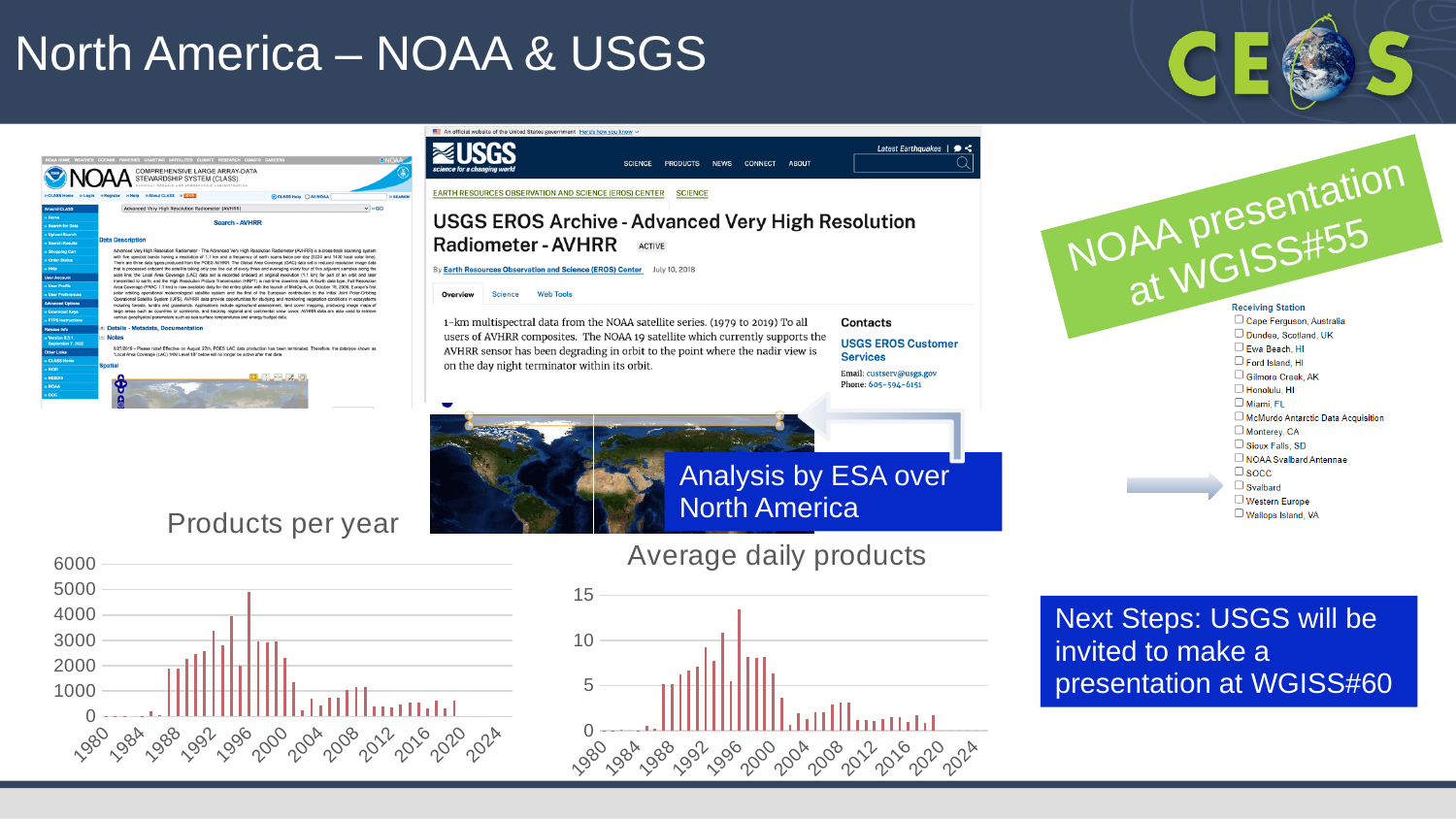
In the 'Products per year' chart, do the values generally rise or fall from 2000 to 2012? fall In the 'Average daily products' chart, which year has the larger value, 1988 or 2016? 1988 How many charts are shown on the slide? 2 In the 'Products per year' chart, which year has the larger value, 1996 or 2012? 1996 In the 'Products per year' chart, is the value for 1992 greater or less than 1000? greater In the 'Products per year' chart, what is the highest value shown on the y axis? 6000 What is the title of the chart on the right side of the slide? Average daily products In the 'Average daily products' chart, is the value for 2020 greater or less than 5? less What kind of chart is the 'Products per year' chart? bar chart In the 'Products per year' chart, is the highest bar greater or less than 4000? greater